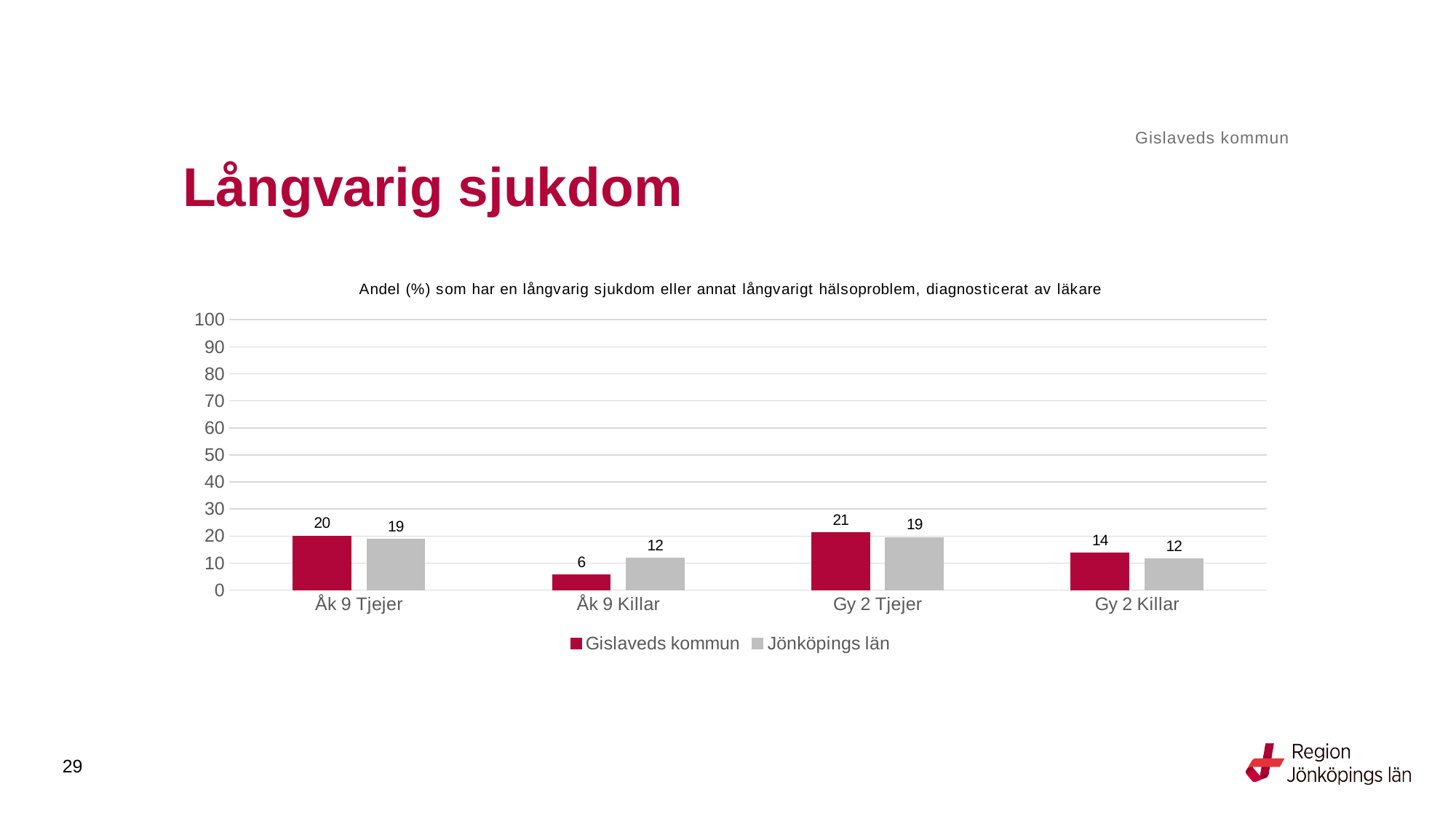
What is the value for Jönköpings län in the Åk 9 Killar category? 12 Which series is shown in red? Gislaveds kommun How many series does the legend list? 2 What is the difference between Jönköpings län and Gislaveds kommun in the Åk 9 Killar category? 6 Which category has the lowest value for Gislaveds kommun? Åk 9 Killar In the Gy 2 Tjejer category, which is larger: Gislaveds kommun or Jönköpings län? Gislaveds kommun What kind of chart is shown on the slide? bar chart Is the value for Gislaveds kommun in Gy 2 Tjejer greater or less than 30? less What is the value for Gislaveds kommun in the Gy 2 Killar category? 14 Which category has the highest value for Gislaveds kommun? Gy 2 Tjejer How many categories are shown on the x axis? 4 What is the value for Gislaveds kommun in the Åk 9 Tjejer category? 20